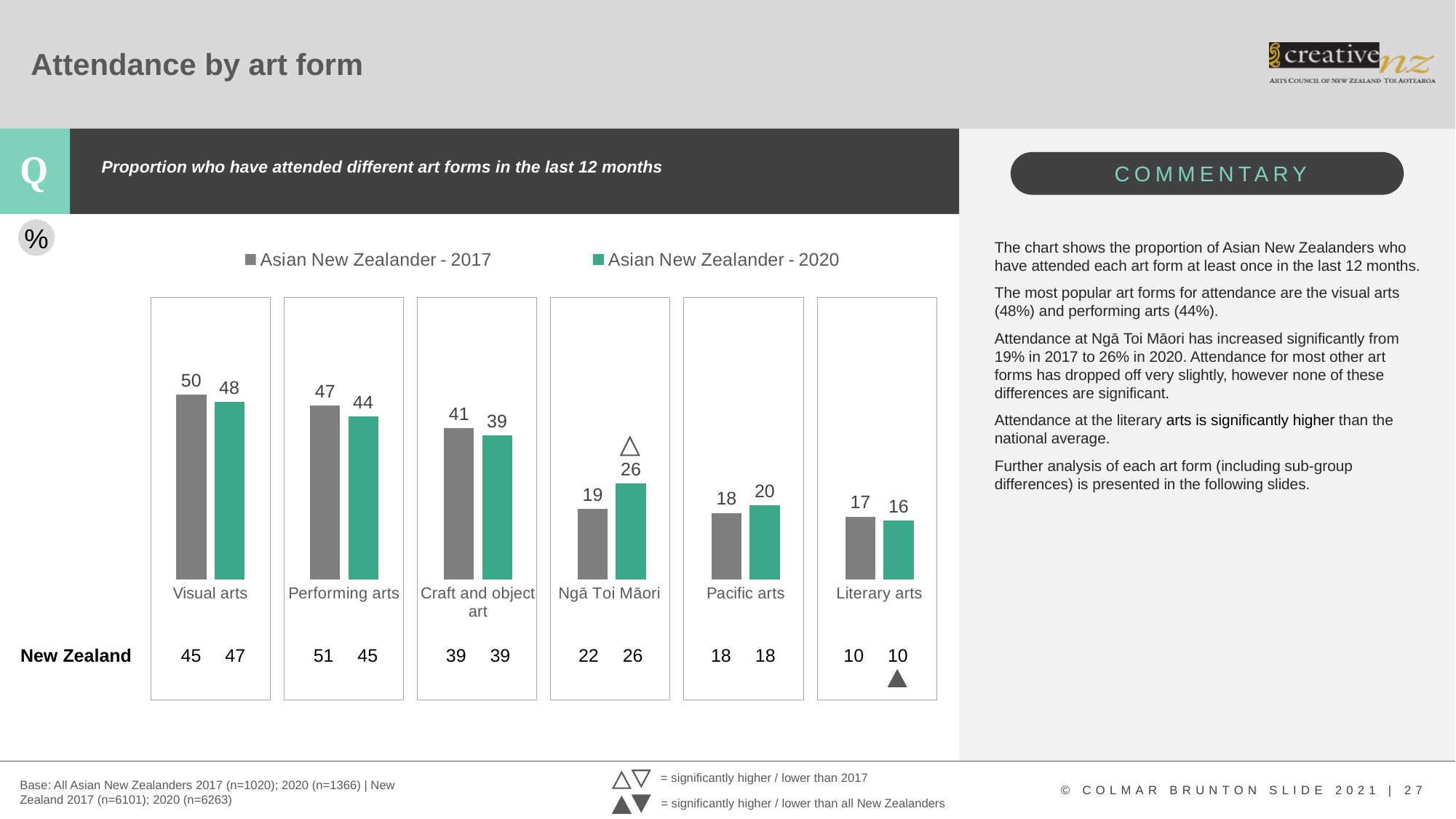
What is the New Zealand 2020 value shown below the chart for Performing arts? 45 Which art form has the lowest value for Asian New Zealander - 2017? Literary arts Which is larger for Performing arts: the Asian New Zealander - 2017 value or the Asian New Zealander - 2020 value? Asian New Zealander - 2017 What is the value for Literary arts for Asian New Zealander - 2020? 16 How many series does the legend list? 2 What is the value for Visual arts for Asian New Zealander - 2017? 50 Which art form has the highest value for Asian New Zealander - 2020? Visual arts What is the value for Ngā Toi Māori for Asian New Zealander - 2020? 26 What kind of chart is shown on the slide? Bar chart Which colour represents Asian New Zealander - 2020 in the chart? Green How many art form categories are shown in the chart? 6 What is the difference between the 2017 and 2020 values for Ngā Toi Māori among Asian New Zealanders? 7